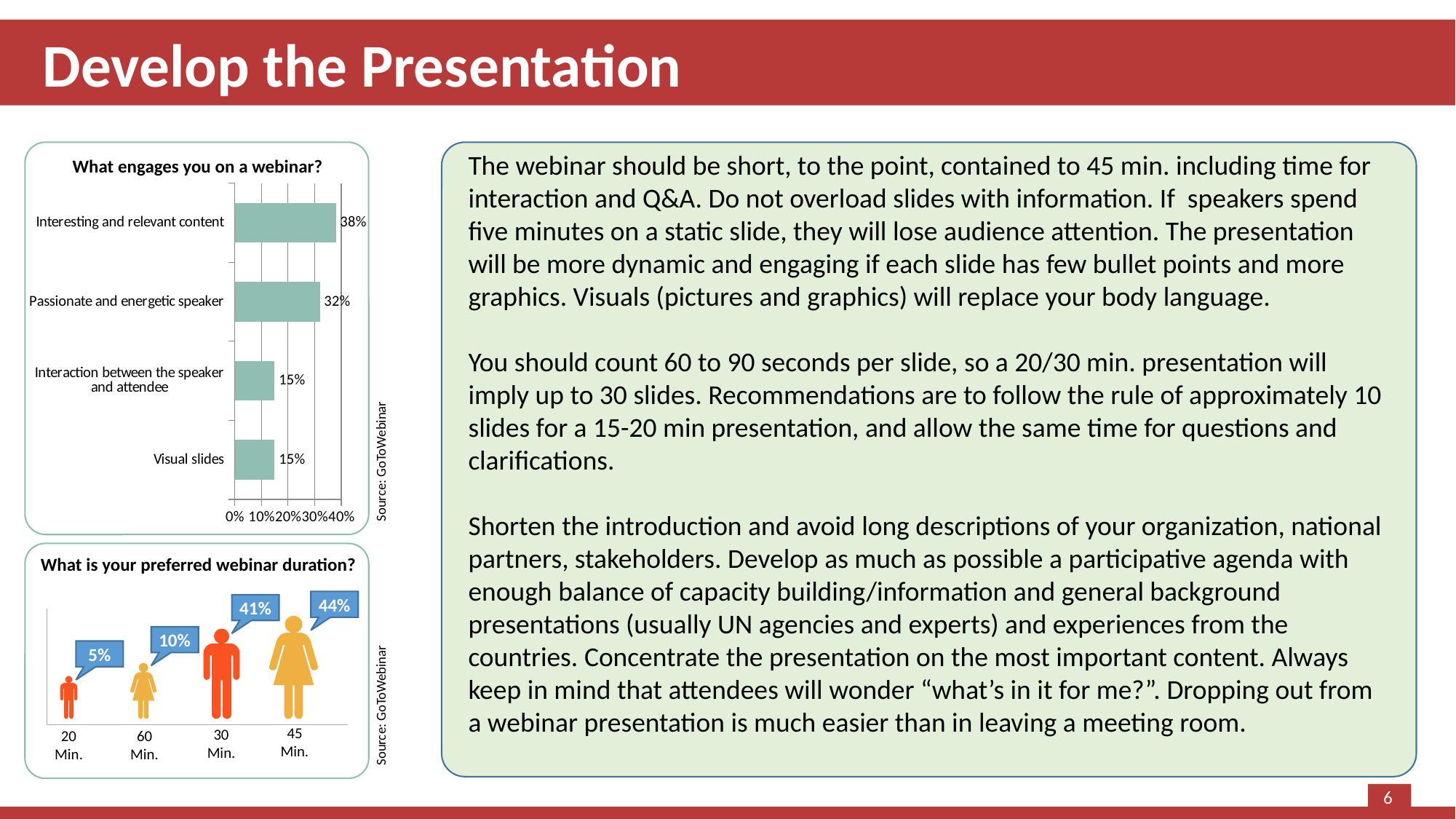
In the chart 'What engages you on a webinar?', which category has the highest value? Interesting and relevant content In the chart 'What is your preferred webinar duration?', which duration has the lowest value? 20 Min. In the chart 'What engages you on a webinar?', what is the difference between 'Interesting and relevant content' and 'Passionate and energetic speaker'? 6% In the chart 'What is your preferred webinar duration?', what is the value for 45 Min.? 44% What kind of chart is 'What engages you on a webinar?'? Bar chart In the chart 'What engages you on a webinar?', how many categories are shown? 4 In the chart 'What engages you on a webinar?', what is the value for 'Passionate and energetic speaker'? 32% In the chart 'What engages you on a webinar?', what is the value for 'Interesting and relevant content'? 38% What source is cited for the chart 'What is your preferred webinar duration?'? GoToWebinar In the chart 'What is your preferred webinar duration?', which is larger: the value for 30 Min. or the value for 60 Min.? 30 Min. In the chart 'What is your preferred webinar duration?', what is the value for 20 Min.? 5% In the chart 'What engages you on a webinar?', what is the value for 'Visual slides'? 15%